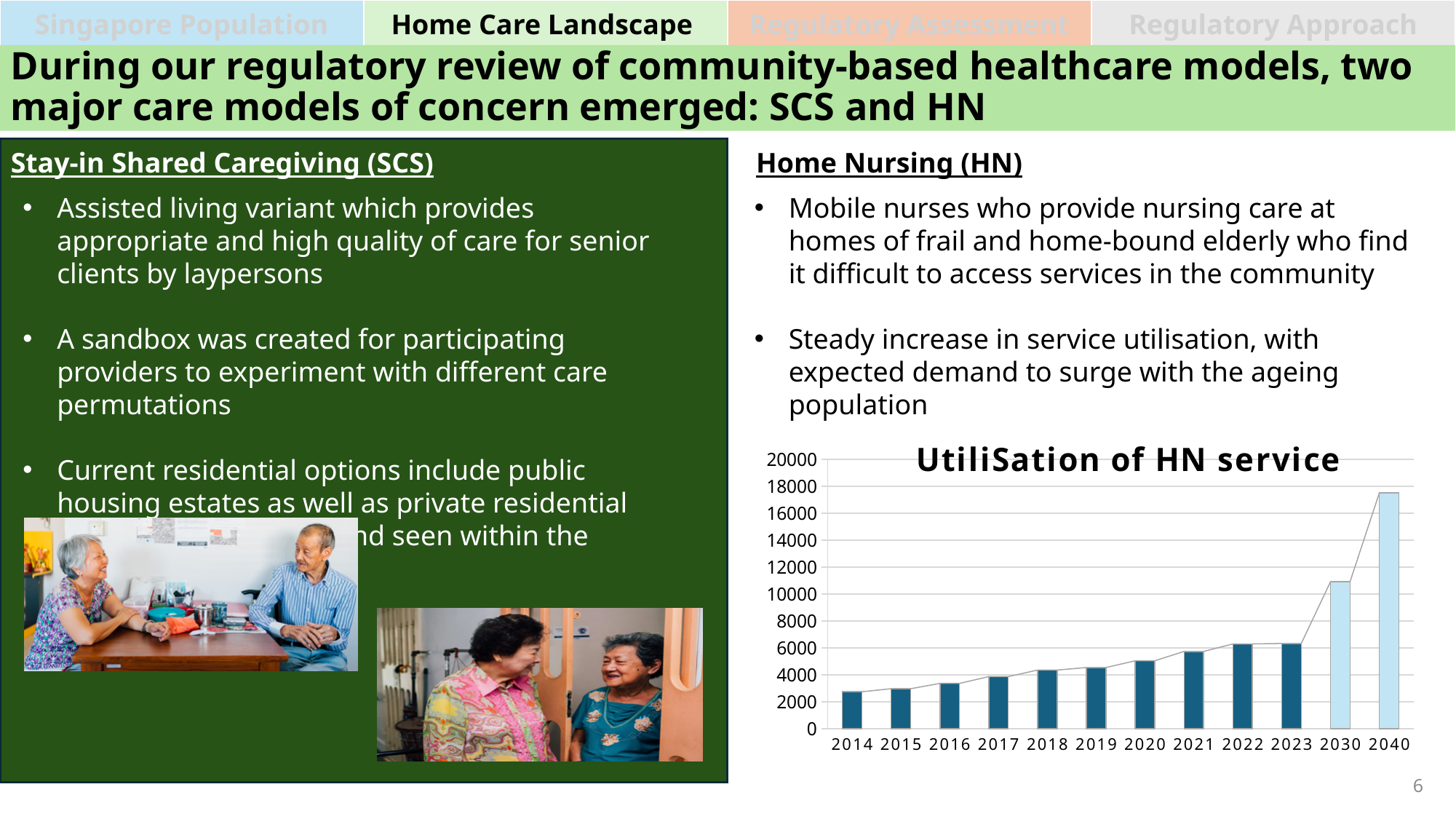
Which year has the lowest utilisation of HN service? 2014 What is the title of the chart on the slide? UtiliSation of HN service Is the value for 2021 greater or less than 6000? less Do the values rise or fall from 2014 to 2040? rise Which two years are shown with lighter blue bars than the rest? 2030 and 2040 Which is larger, the value for 2030 or the value for 2023? 2030 Is the value for 2040 greater or less than 16000? greater Is the value for 2014 greater or less than 4000? less How many years are shown on the x axis of the chart? 12 Which year has the highest utilisation of HN service? 2040 What kind of chart is used to show utilisation of HN service? bar chart